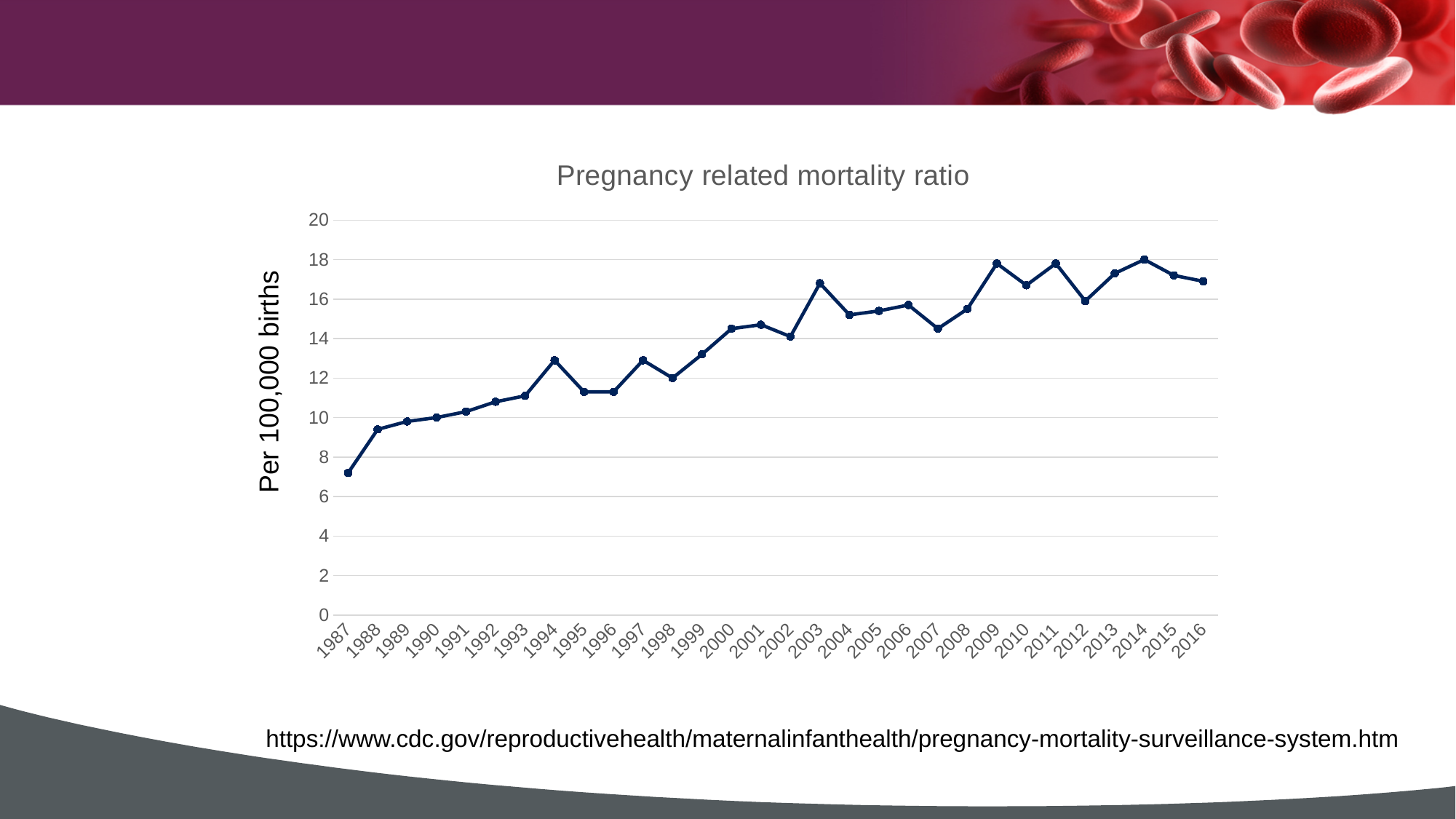
Is the value for 1987 greater or less than 8? less What is the title of the chart? Pregnancy related mortality ratio How many years are plotted on the x axis of the chart? 30 Overall, does the pregnancy related mortality ratio rise or fall from 1987 to 2016? rise Is the value for 2007 greater or less than 16? less Is the value for 2003 greater or less than 16? greater Which year has the higher pregnancy related mortality ratio, 2002 or 2003? 2003 What kind of chart is shown on the slide? line chart Which year has the lowest pregnancy related mortality ratio? 1987 Which year has the higher pregnancy related mortality ratio, 1994 or 1995? 1994 What is the label on the vertical axis of the chart? Per 100,000 births